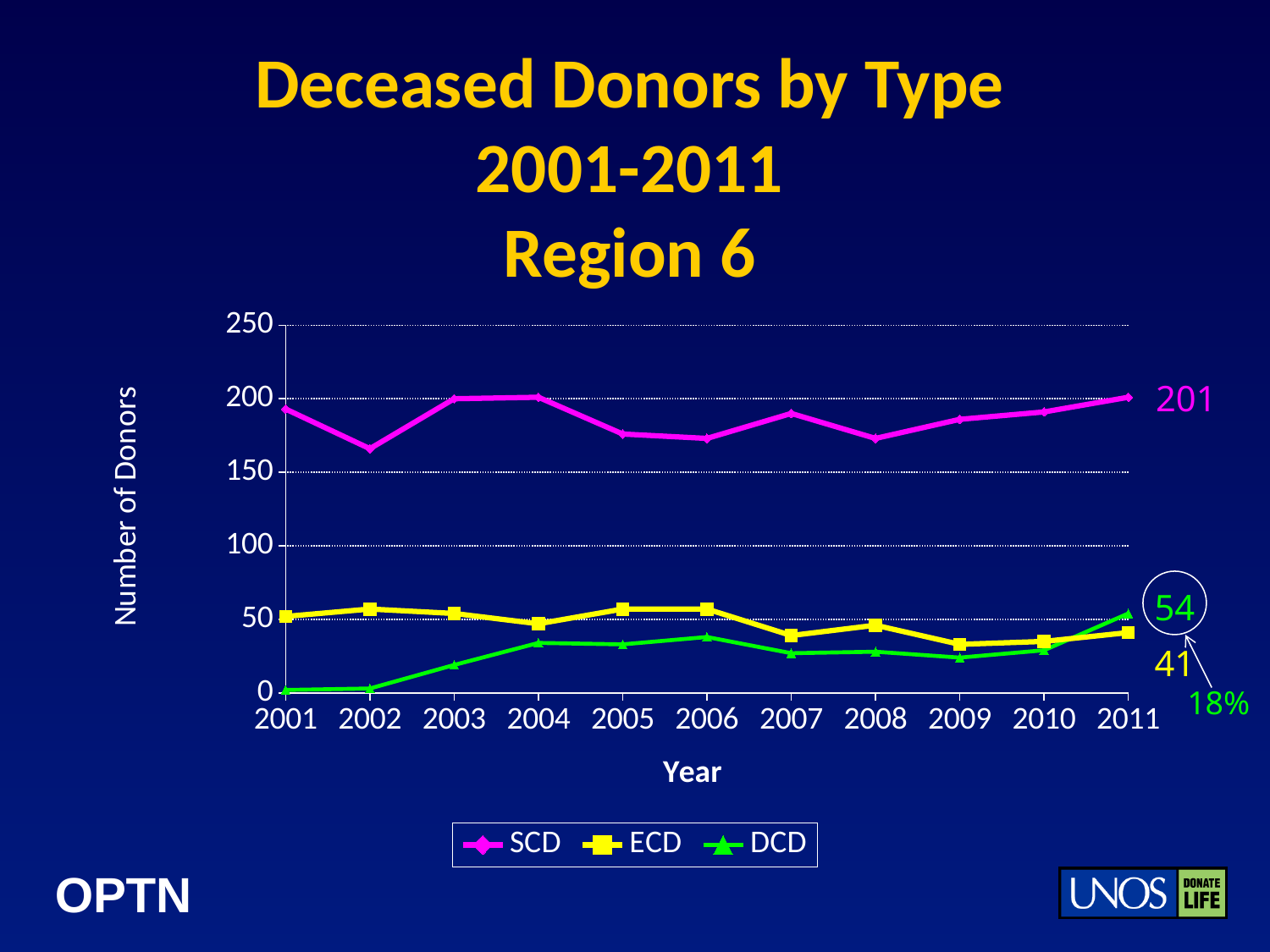
What is the number of DCD donors in 2011? 54 What is the number of ECD donors in 2011? 41 What percentage label is shown next to the 2011 data points? 18% In 2011, which is larger: DCD or ECD? DCD How many series does the legend list? 3 What type of chart is shown on the slide? Line chart Is the value for DCD in 2001 greater or less than 50? less Does the DCD line rise or fall from 2001 to 2011? Rises How many years are plotted along the x axis? 11 What is the difference between DCD and ECD donors in 2011? 13 What is the number of SCD donors in 2011? 201 Which donor type has the highest value in 2011? SCD